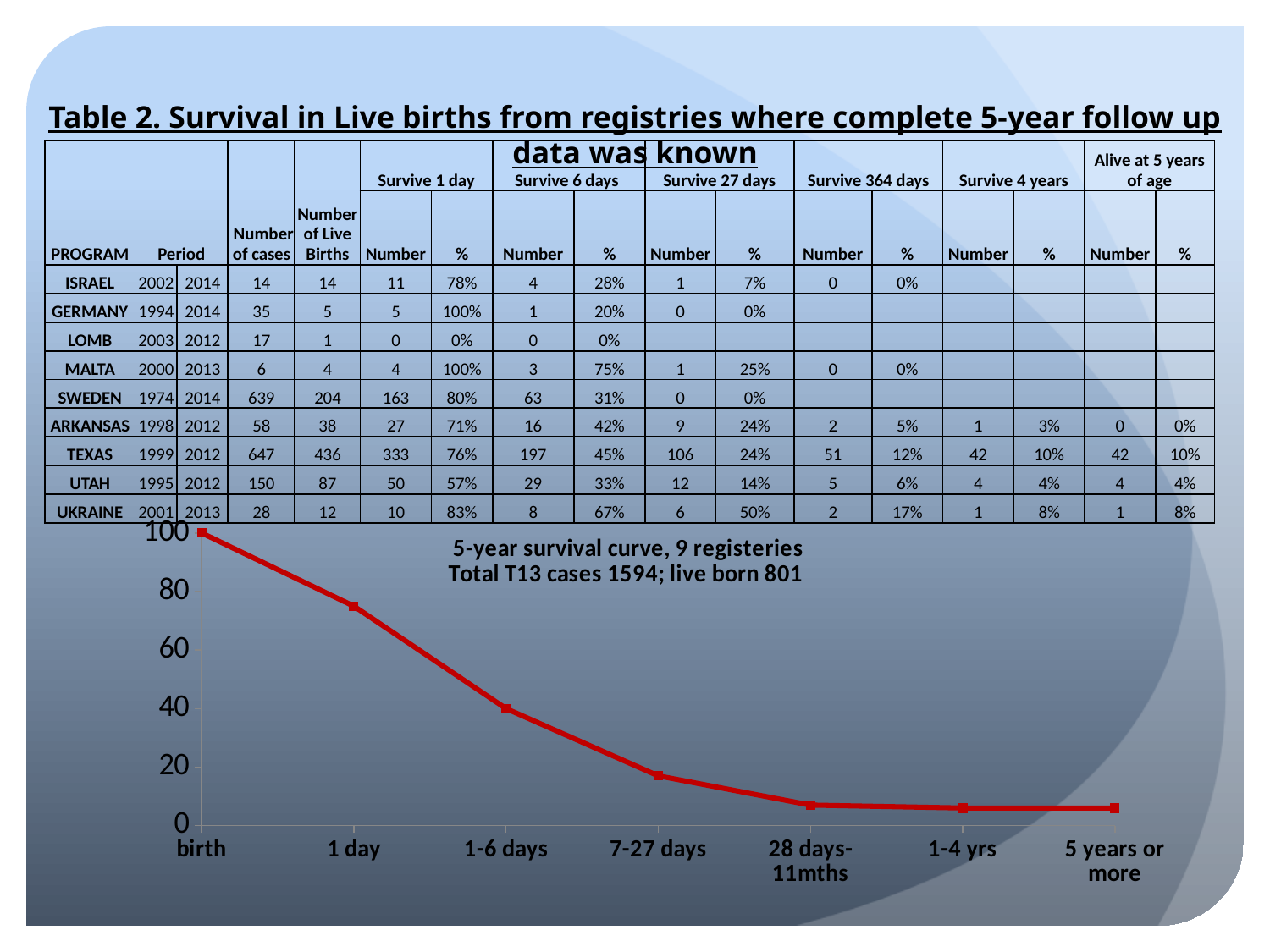
Do the values on the 5-year survival curve rise or fall from birth to 5 years or more? fall On the 5-year survival curve, is the value for 28 days-11mths greater or less than 20? less How many points are plotted on the 5-year survival curve? 7 What is the value of the 5-year survival curve at birth? 100 What kind of chart is shown below the table on the slide? line chart On the 5-year survival curve, is the value for 1-6 days greater or less than 60? less According to the chart title, how many live born T13 cases are included in the survival curve? 801 On the 5-year survival curve, is the value for 1 day greater or less than 60? greater On the 5-year survival curve, which is larger, the value for 1 day or the value for 1-6 days? 1 day According to the chart title, how many registries does the 5-year survival curve cover? 9 Which x-axis category has the highest value on the 5-year survival curve? birth